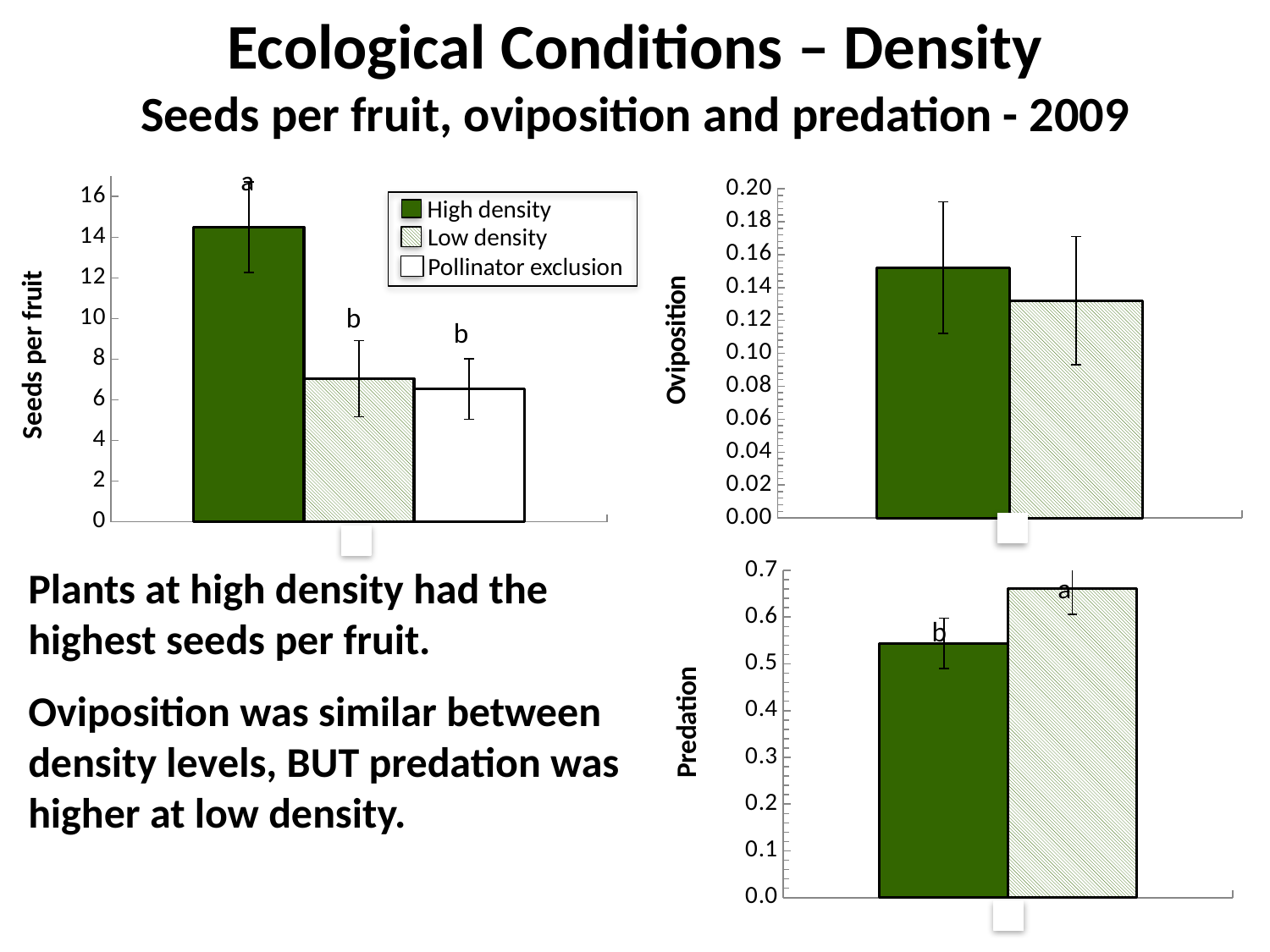
On the 'Predation' chart at the bottom right, which is larger, the value for High density or Low density? Low density On the 'Seeds per fruit' chart, what colour is the High density series in the legend? dark green On the 'Seeds per fruit' chart, how many bars are plotted? 3 On the 'Predation' chart at the bottom right, is the value for Low density greater or less than 0.6? greater On the 'Seeds per fruit' chart, is the value for Low density greater or less than 8? less On the 'Oviposition' chart at the top right, is the value for Low density greater or less than 0.14? less On the 'Seeds per fruit' chart, which series has the highest value? High density How many series does the legend on the 'Seeds per fruit' chart list? 3 What kind of chart is the 'Seeds per fruit' chart on the left of the slide? bar chart